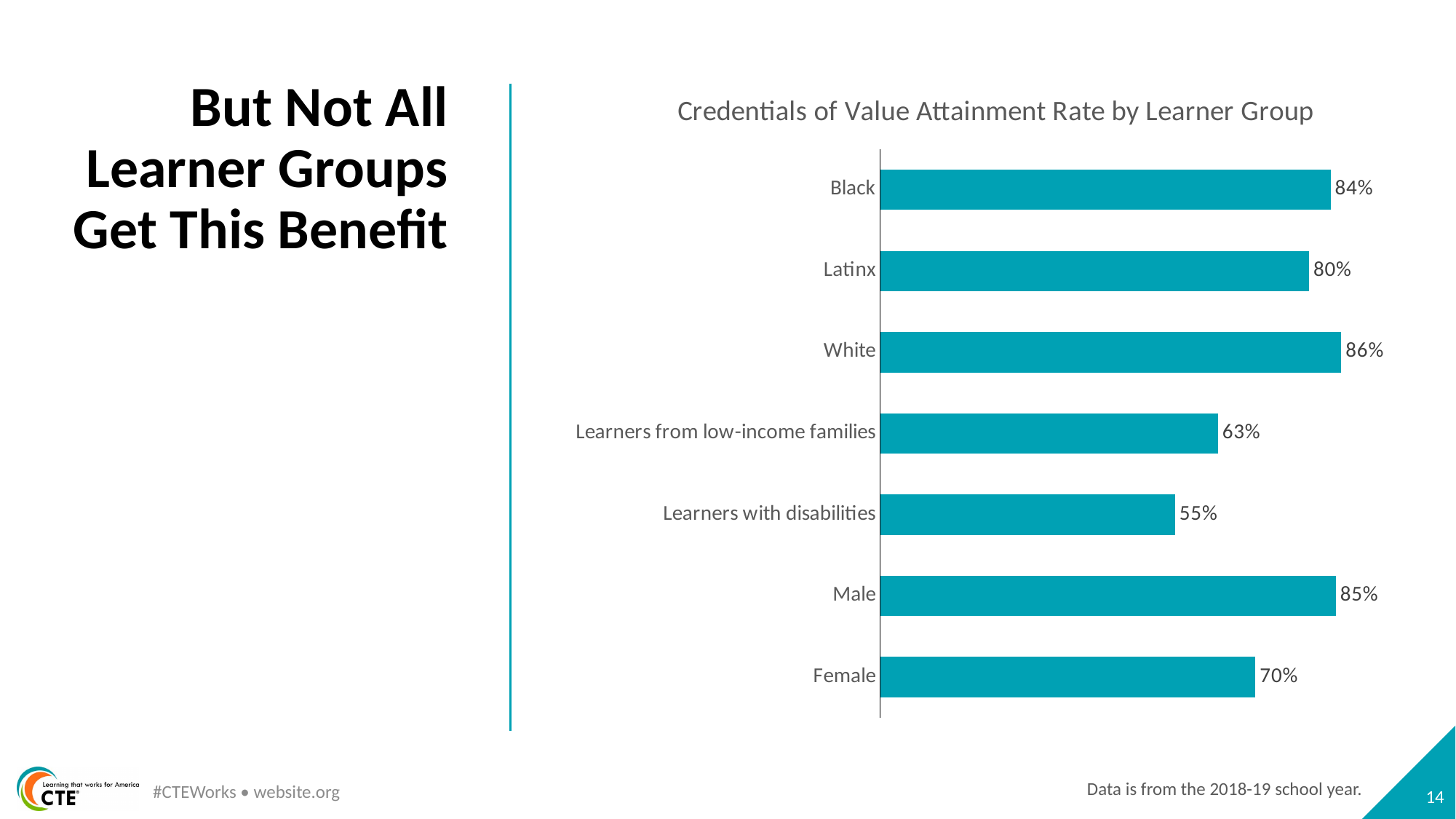
What is the difference in attainment rate between Male and Female learners? 15% Which learner group has the highest attainment rate? White What is the attainment rate for learners from low-income families? 63% What is the attainment rate for learners with disabilities? 55% How many learner groups are shown in the chart? 7 What is the difference in attainment rate between White and Black learners? 2% What is the title of the chart? Credentials of Value Attainment Rate by Learner Group What is the attainment rate for Female learners? 70% What kind of chart is shown on the slide? Bar chart What is the credentials of value attainment rate for Black learners? 84% Which learner group has the lowest attainment rate? Learners with disabilities Which has a higher attainment rate, Latinx learners or learners from low-income families? Latinx